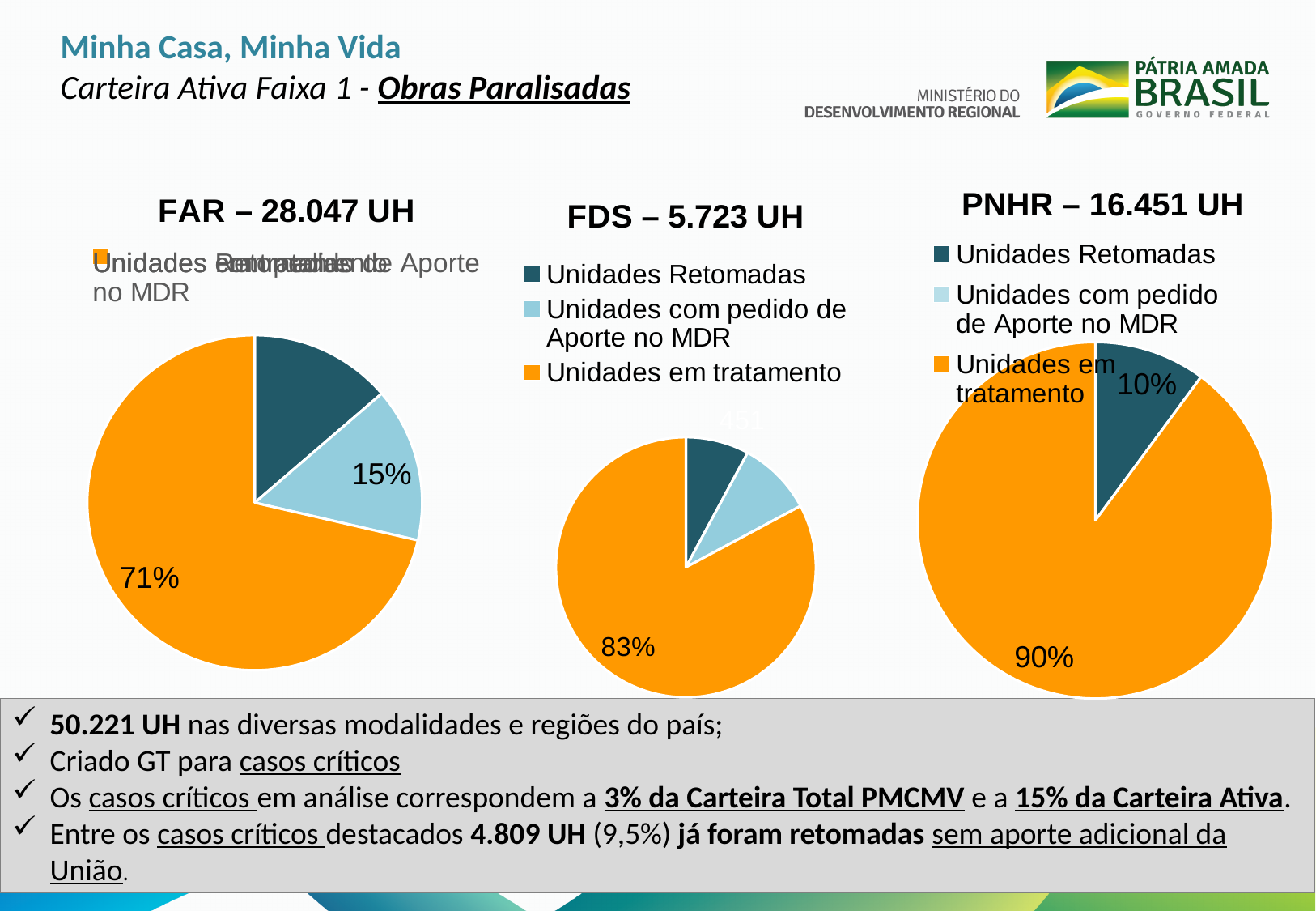
In the PNHR – 16.451 UH chart, which category has the largest slice? Unidades em tratamento In the FDS – 5.723 UH chart, what share is labelled for Unidades em tratamento? 83% In the FDS – 5.723 UH chart, which category has the largest slice? Unidades em tratamento In the PNHR – 16.451 UH chart, what share is labelled for Unidades em tratamento? 90% In the FAR – 28.047 UH chart, what share is shown for Unidades com pedido de Aporte no MDR? 15% Which colour represents Unidades em tratamento in the PNHR – 16.451 UH chart? Orange What kind of charts are shown on the slide? Pie charts How many entries does the legend of the FDS – 5.723 UH chart list? 3 How many pie charts are on the slide? 3 In the PNHR – 16.451 UH chart, what is the difference between the Unidades em tratamento share and the Unidades Retomadas share? 80%